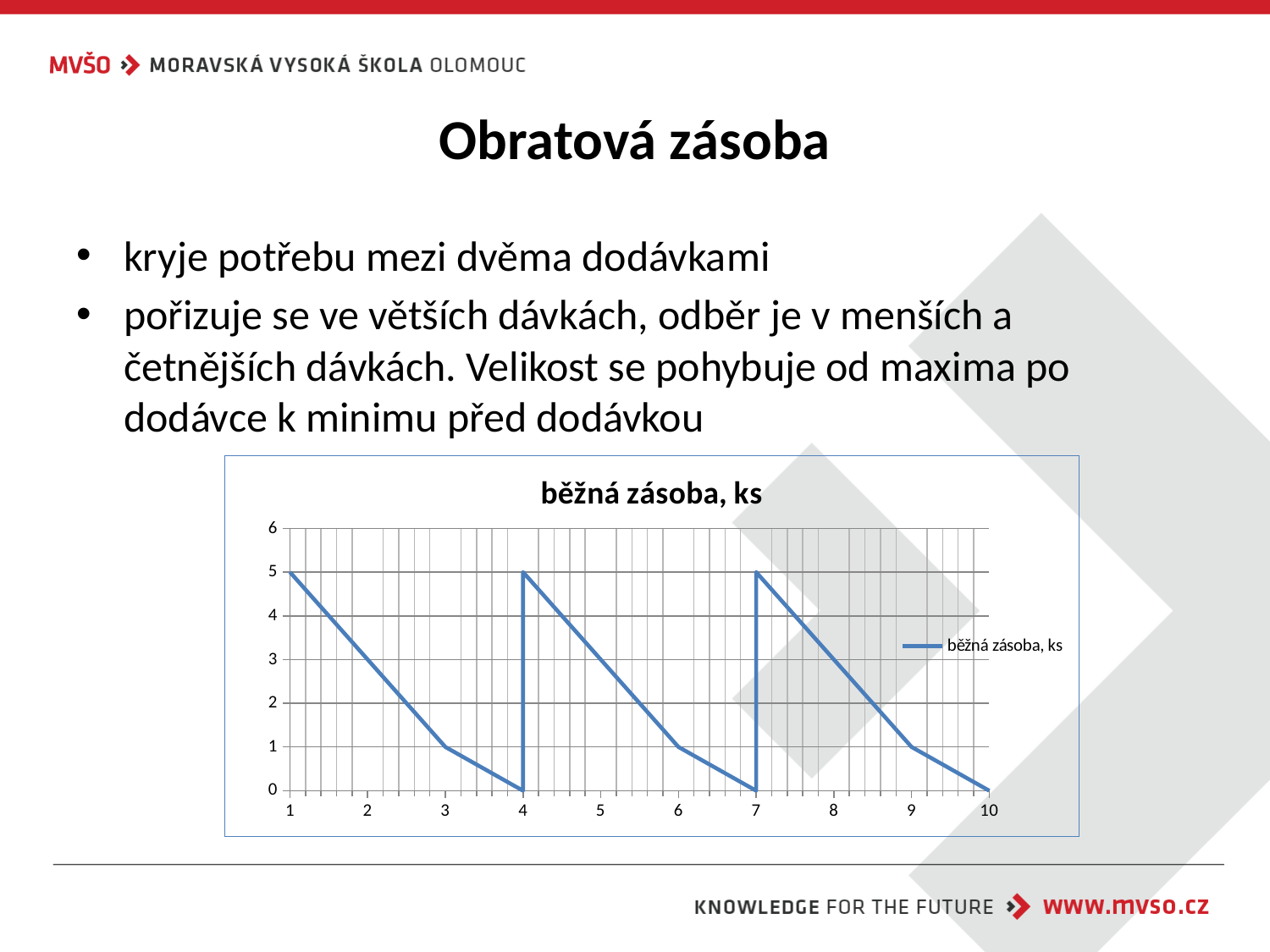
What is the value of běžná zásoba at x = 1? 5 What is the lowest value reached by the line on the chart? 0 What kind of chart is shown on the slide? line chart How many points are labelled on the x axis of the chart? 10 How many series does the chart legend list? 1 Between x = 1 and x = 3, does the value of běžná zásoba rise or fall? fall Which is larger, the value of běžná zásoba at x = 2 or at x = 3? x = 2 What is the highest value reached by the line on the chart? 5 What is the title of the chart? běžná zásoba, ks What is the value of běžná zásoba at x = 2? 3 What is the value of běžná zásoba at x = 10? 0 What is the value of běžná zásoba at x = 3? 1